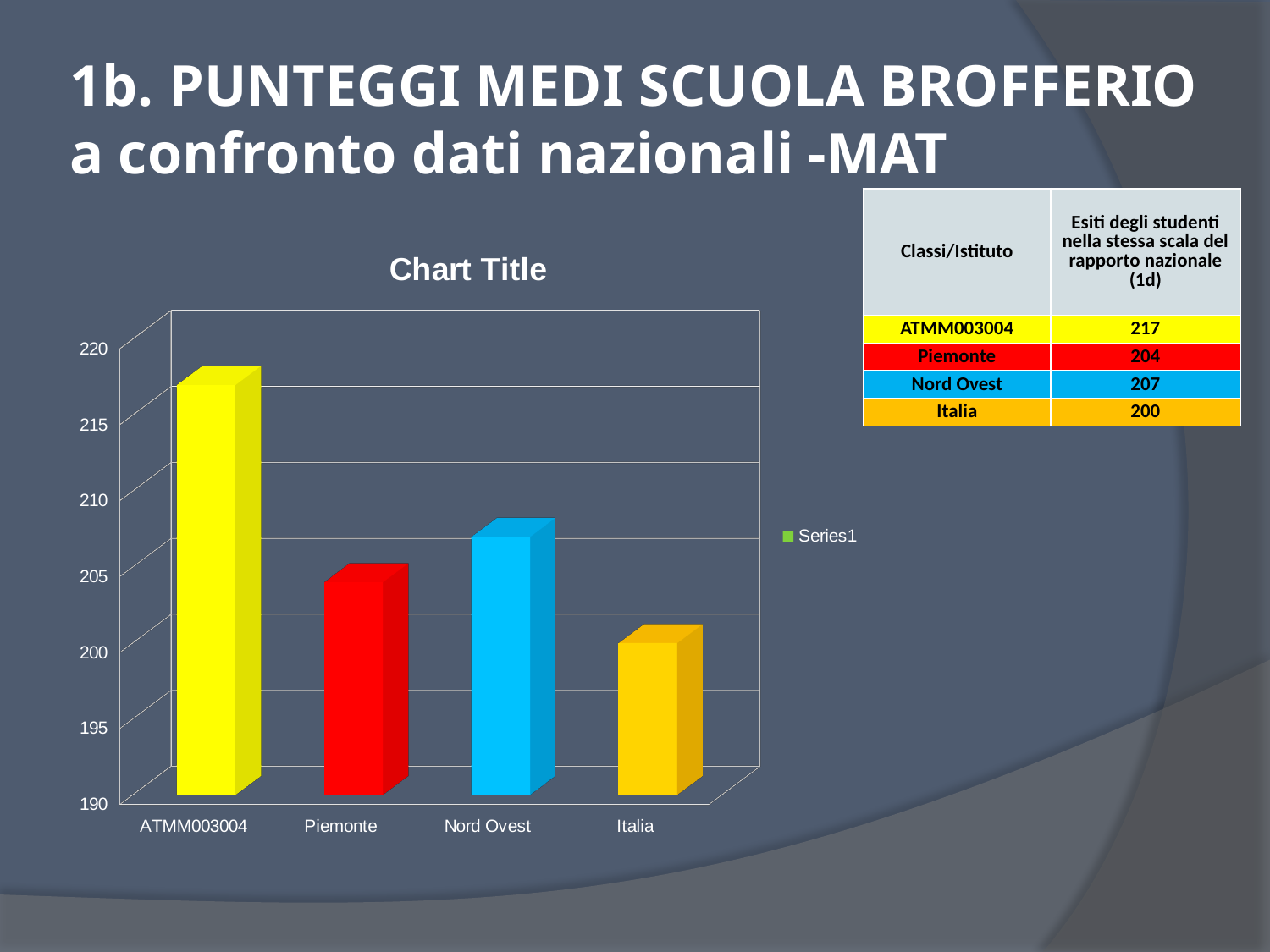
Is the value for Piemonte greater or less than 205? less What is the difference between the values for ATMM003004 and Italia shown in the table? 17 According to the table on the slide, what is the value for Nord Ovest? 207 Which category has the lowest bar in the chart? Italia How many series does the chart legend list? 1 What is the title shown above the chart? Chart Title According to the table on the slide, what is the value for ATMM003004? 217 Which is larger, the bar for Nord Ovest or the bar for Piemonte? Nord Ovest What kind of chart is shown on the slide? bar chart Which category has the highest bar in the chart? ATMM003004 How many categories are plotted on the x axis of the chart? 4 According to the table on the slide, what is the value for Piemonte? 204